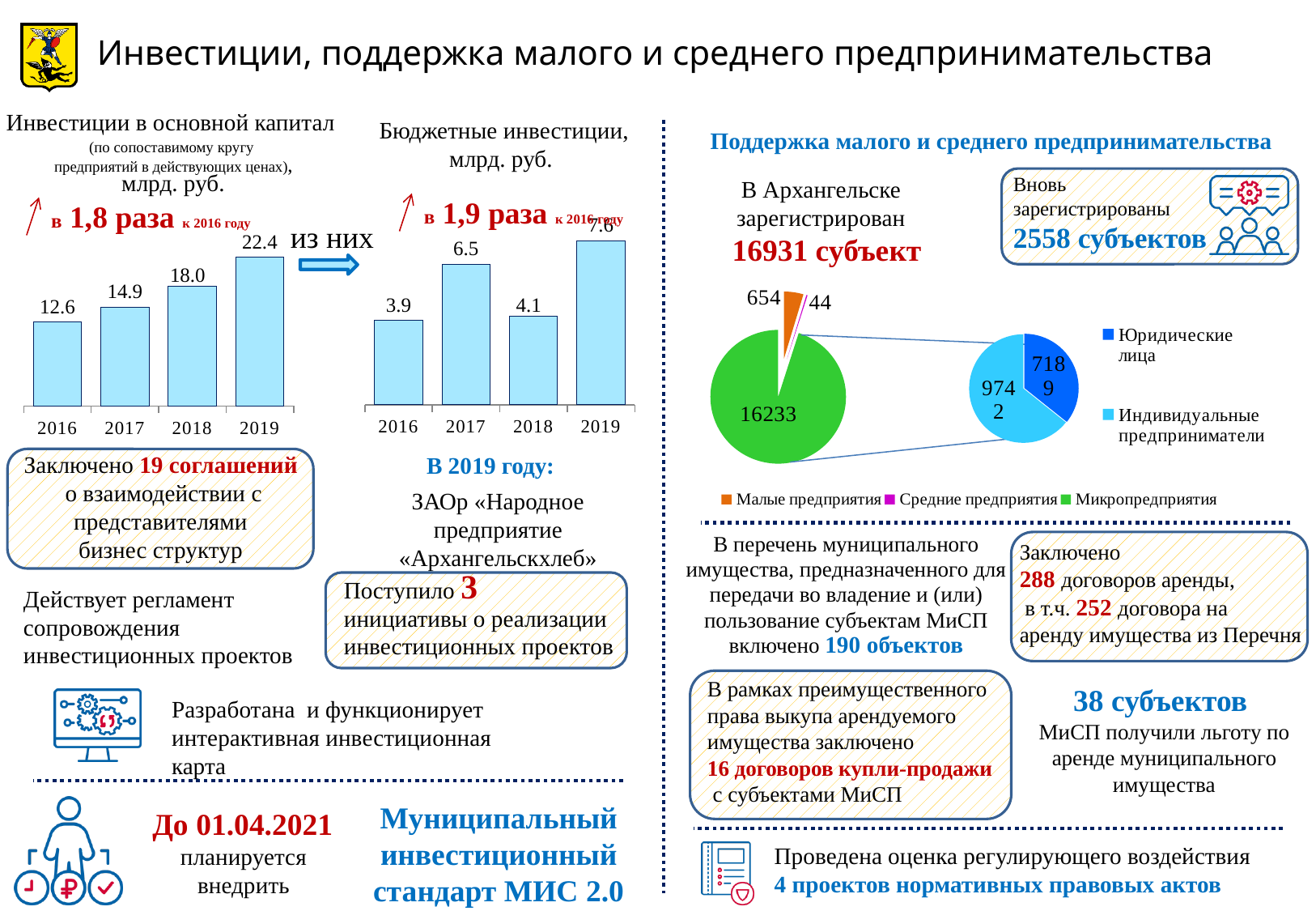
In the small pie chart on the right side of the slide, which is larger: 'Юридические лица' or 'Индивидуальные предприниматели'? Индивидуальные предприниматели In the chart 'Бюджетные инвестиции, млрд. руб.', what is the value for 2017? 6.5 In the chart 'Бюджетные инвестиции, млрд. руб.', how many years are shown on the x axis? 4 In the large pie chart on the right side of the slide, what is the value for 'Микропредприятия'? 16233 In the chart 'Инвестиции в основной капитал', what is the difference between the 2019 and 2016 values? 9.8 What kind of chart is 'Бюджетные инвестиции, млрд. руб.'? bar chart In the chart 'Инвестиции в основной капитал', what is the value for 2019? 22.4 In the chart 'Бюджетные инвестиции, млрд. руб.', which year has the highest value? 2019 In the large pie chart on the right side of the slide, which category has the smallest slice? Средние предприятия In the chart 'Инвестиции в основной капитал', do the values rise or fall from 2016 to 2019? rise In the chart 'Бюджетные инвестиции, млрд. руб.', which year has the lowest value? 2016 In the chart 'Инвестиции в основной капитал', what is the value for 2016? 12.6